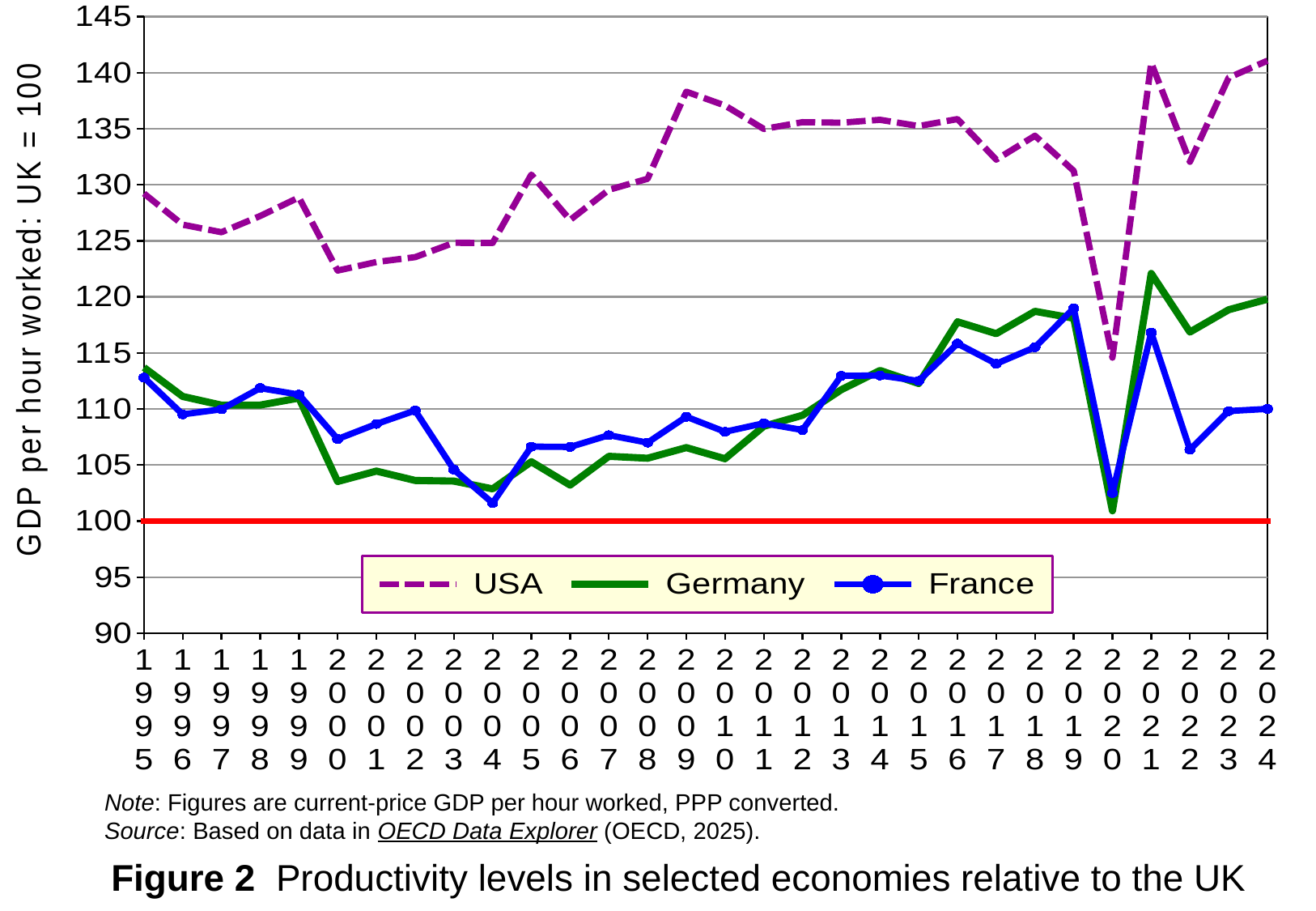
How many series does the legend list? 3 Is the value for USA in 2020 greater or less than 120? less Which series has the highest values across the whole period? USA In which year does the Germany series reach its lowest value? 2020 In 2021, which is higher, Germany or France? Germany What is the y-axis title of the chart? GDP per hour worked: UK = 100 What kind of chart is shown in Figure 2? line chart Is the value for USA in 2009 greater or less than 135? greater Does the USA series rise or fall between 2000 and 2009? rise How many years are plotted along the x axis? 30 Is the value for France in 2004 greater or less than 105? less